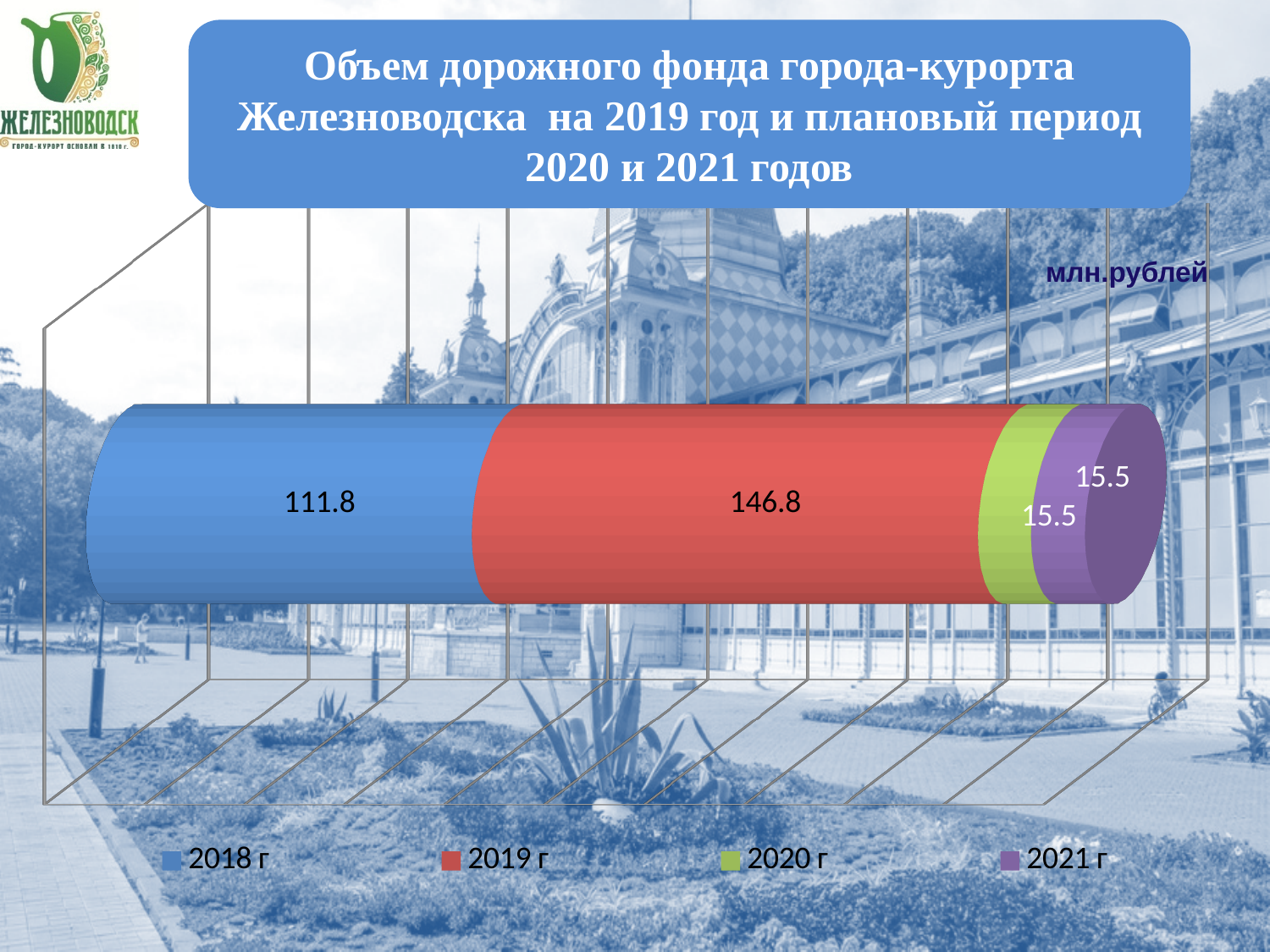
Which is larger, the value for 2018 г or the value for 2019 г? 2019 г What is the value for 2018 г? 111.8 What is the total of all segments in the stacked bar? 289.6 What unit of measurement is shown on the chart? млн.рублей What is the value for 2020 г? 15.5 Which year has the highest value? 2019 г Which colour represents 2019 г in the legend? Red What kind of chart is shown on the slide? Stacked bar chart How many series does the legend list? 4 What is the difference between the values for 2019 г and 2018 г? 35 What is the value for 2021 г? 15.5 What is the value for 2019 г? 146.8